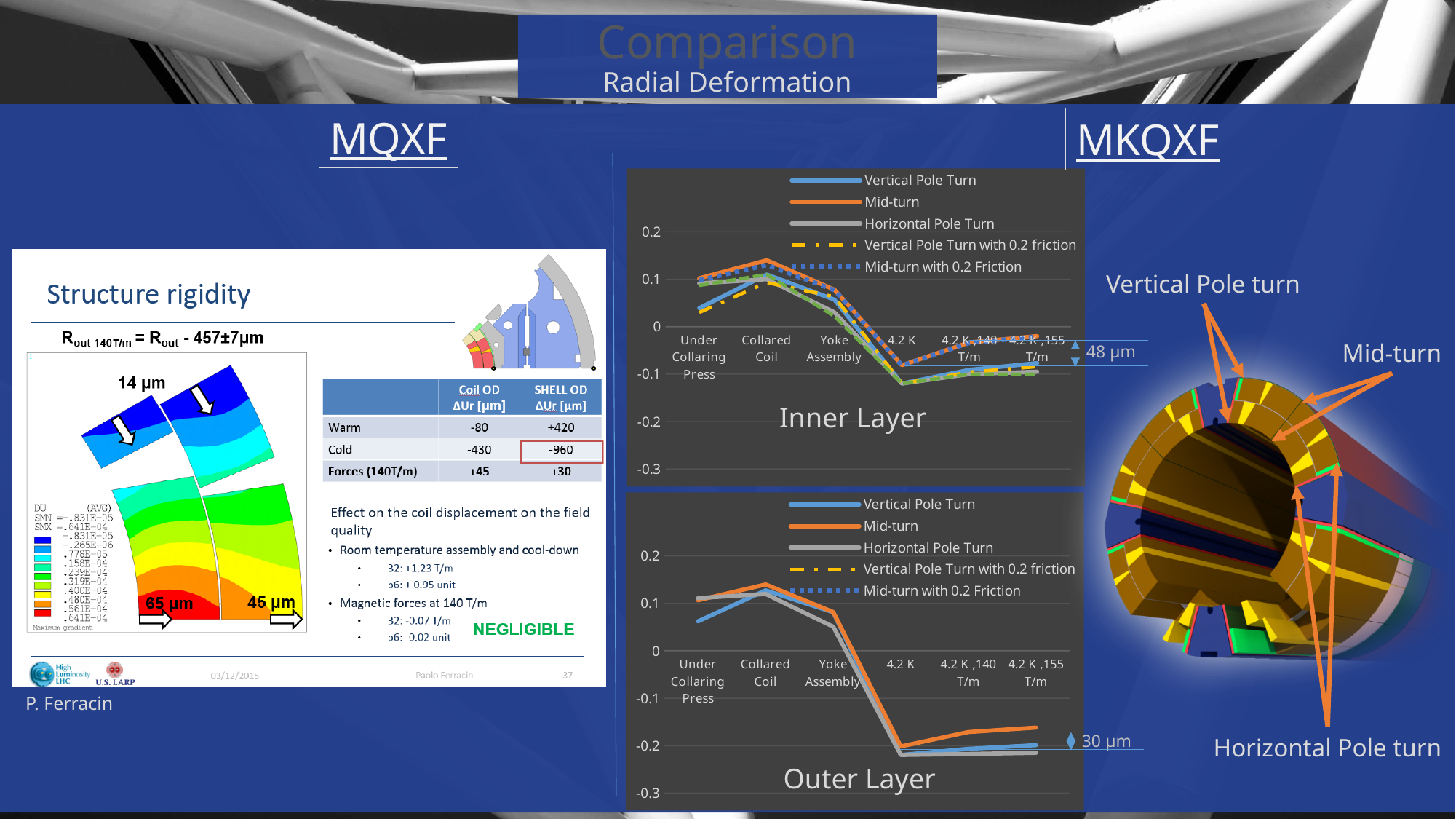
In the Inner Layer chart, is the Mid-turn value at 4.2 K greater or less than 0? less In the Outer Layer chart, do the Mid-turn values rise or fall from Yoke Assembly to 4.2 K? fall In the Outer Layer chart, is the Mid-turn value at 4.2 K ,155 T/m greater or less than -0.2? greater What difference annotation is shown next to the right end of the Inner Layer chart? 48 µm How many categories are shown on the x axis of the Inner Layer chart? 6 How many series does the legend of the Outer Layer chart list? 5 In the Outer Layer chart, is the Horizontal Pole Turn value at 4.2 K greater or less than -0.2? less In the Inner Layer chart, at which category does the Mid-turn series reach its highest value? Collared Coil In the Outer Layer chart, at Under Collaring Press, which is larger: Vertical Pole Turn or Mid-turn? Mid-turn What type of chart is the Inner Layer chart? line chart In the Outer Layer chart, at which category does the Mid-turn series reach its lowest value? 4.2 K